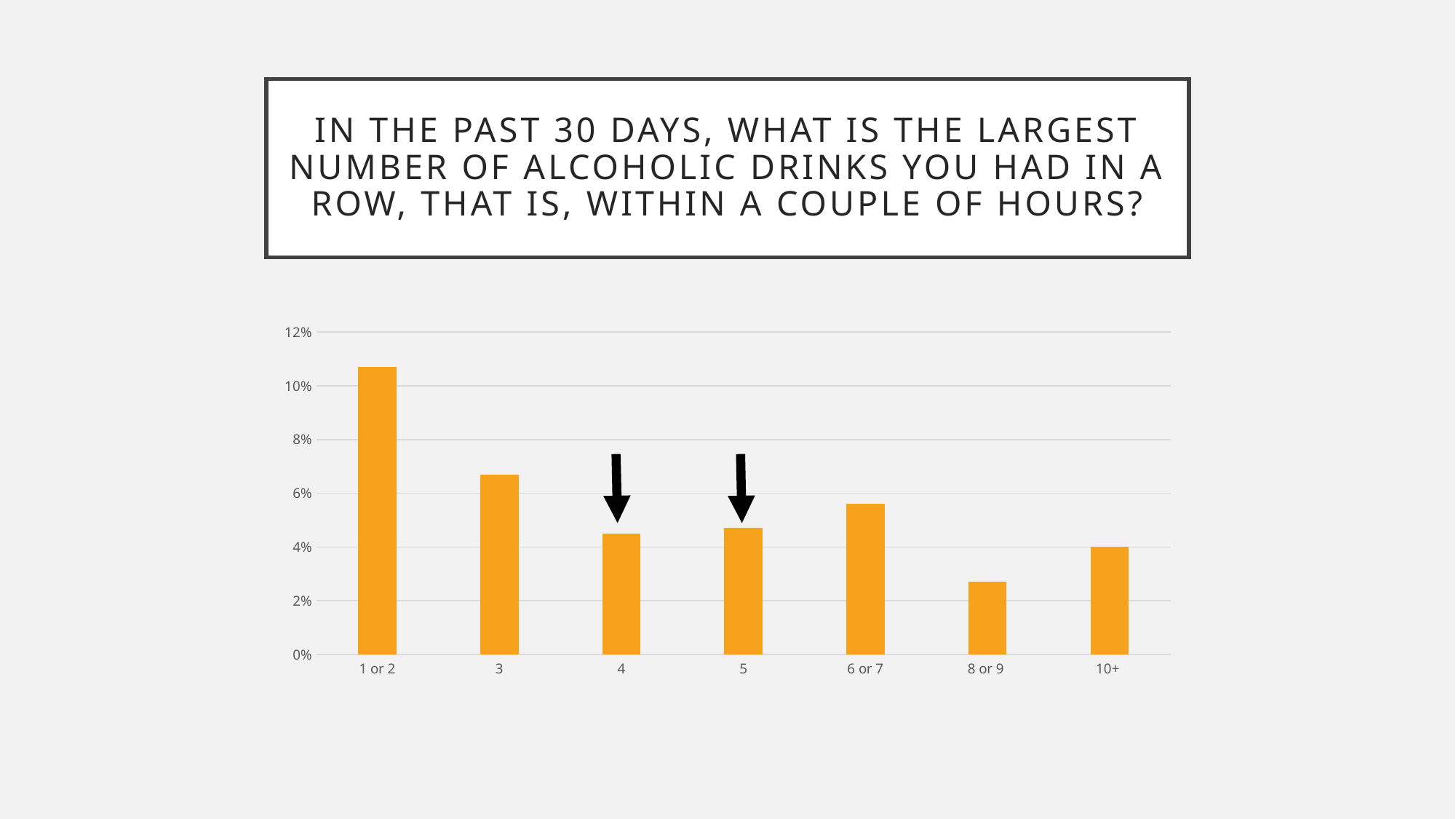
How many categories are shown on the x axis of the chart? 7 Which two categories do the black arrows on the chart point to? 4 and 5 Which is larger, the value for "3" or the value for "6 or 7"? 3 Which category has the highest value in the chart? 1 or 2 Is the value for "5" greater or less than 6%? less Is the value for "1 or 2" greater or less than 10%? greater Is the value for "3" greater or less than 6%? greater What kind of chart is shown on the slide? Bar chart Which is larger, the value for "6 or 7" or the value for "8 or 9"? 6 or 7 Which category has the lowest value in the chart? 8 or 9